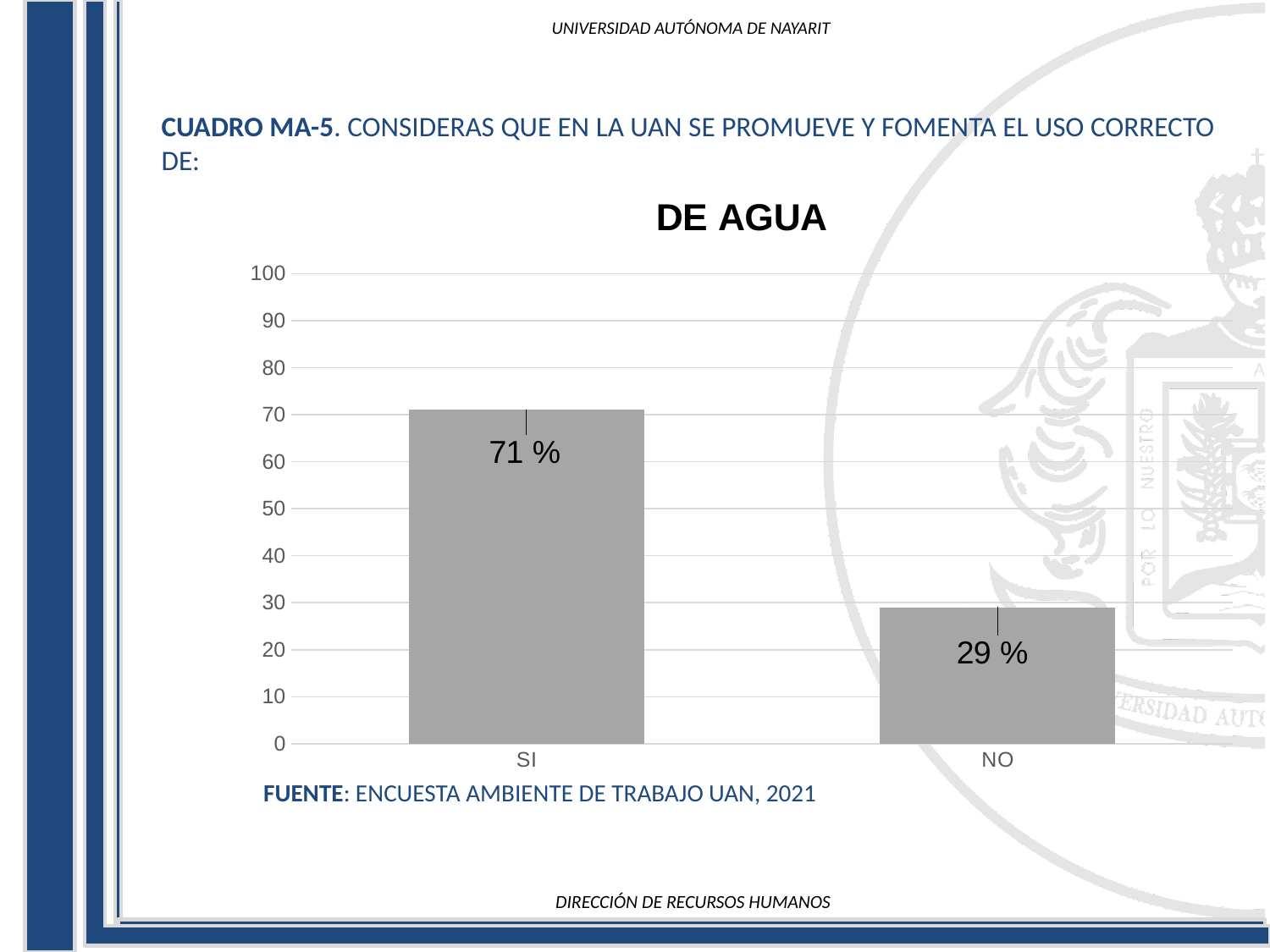
What is the title of the chart? DE AGUA Is the value for SI greater or less than 60? greater Which category has the lowest value? NO What is the value for NO? 29 % What is the highest value shown on the y axis? 100 What is the difference between the values for SI and NO? 42 % What kind of chart is shown on the slide? bar chart Which category has the highest value? SI Is the value for NO greater or less than 40? less What is the value for SI? 71 % Which is larger, the value for SI or the value for NO? SI How many categories are shown on the x axis? 2